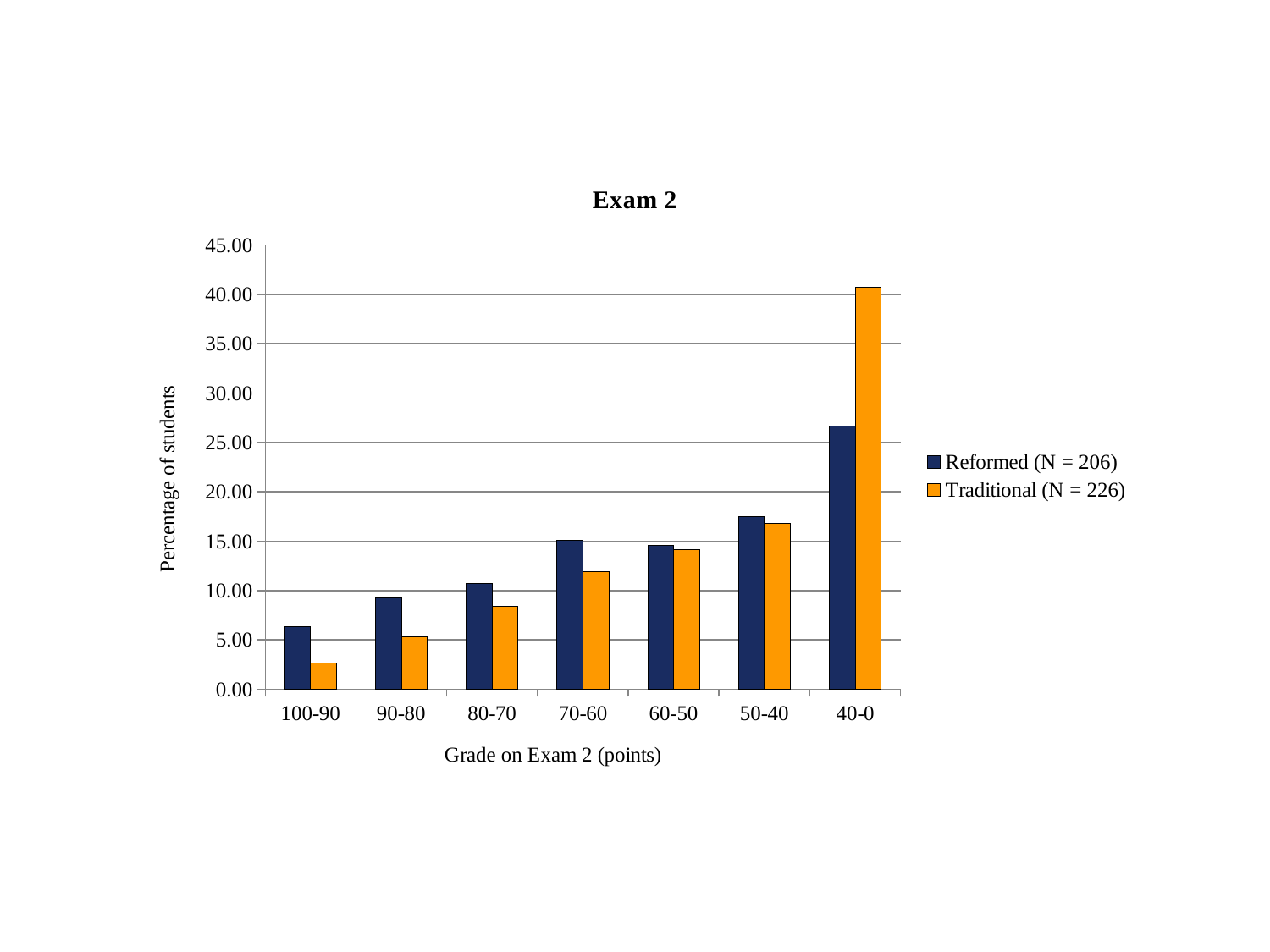
For which grade category is the Reformed (N = 206) value lowest? 100-90 For which grade category is the Traditional (N = 226) value highest? 40-0 In the 100-90 category, which series has the larger value, Reformed (N = 206) or Traditional (N = 226)? Reformed (N = 206) Is the Reformed (N = 206) value for 50-40 greater or less than 20.00? less Do the Traditional (N = 226) values generally rise or fall moving from 100-90 to 40-0 along the x axis? rise Is the Traditional (N = 226) value for 100-90 greater or less than 5.00? less How many grade categories are shown on the x axis? 7 How many series does the legend list? 2 What kind of chart is shown on the slide? bar chart What is the title of the chart? Exam 2 In the 40-0 category, which series has the larger value, Reformed (N = 206) or Traditional (N = 226)? Traditional (N = 226) Is the Traditional (N = 226) value for 40-0 greater or less than 35.00? greater